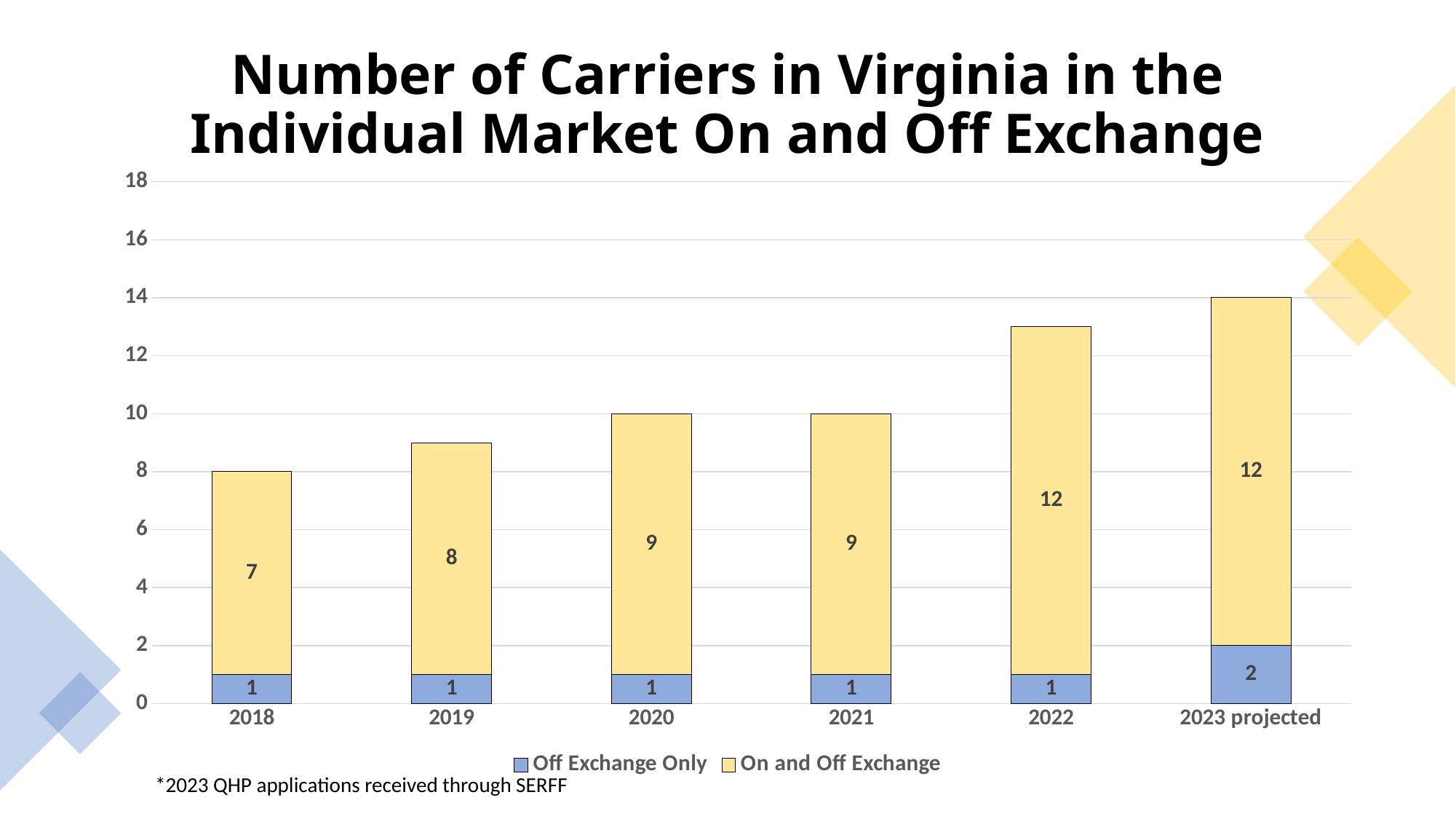
How many years are shown on the x axis? 6 What is the difference between the On and Off Exchange values for 2022 and 2019? 4 What kind of chart is shown on the slide? Stacked bar chart What is the total of the stacked bar for 2023 projected? 14 What is the value for On and Off Exchange in 2020? 9 How many series does the legend list? 2 What is the total of the stacked bar for 2022? 13 What is the value for On and Off Exchange in 2018? 7 What is the value for Off Exchange Only in 2023 projected? 2 Which is larger, the On and Off Exchange value for 2021 or for 2018? 2021 Which year has the lowest value for On and Off Exchange? 2018 Which year has the highest value for On and Off Exchange? 2022 and 2023 projected (both 12)